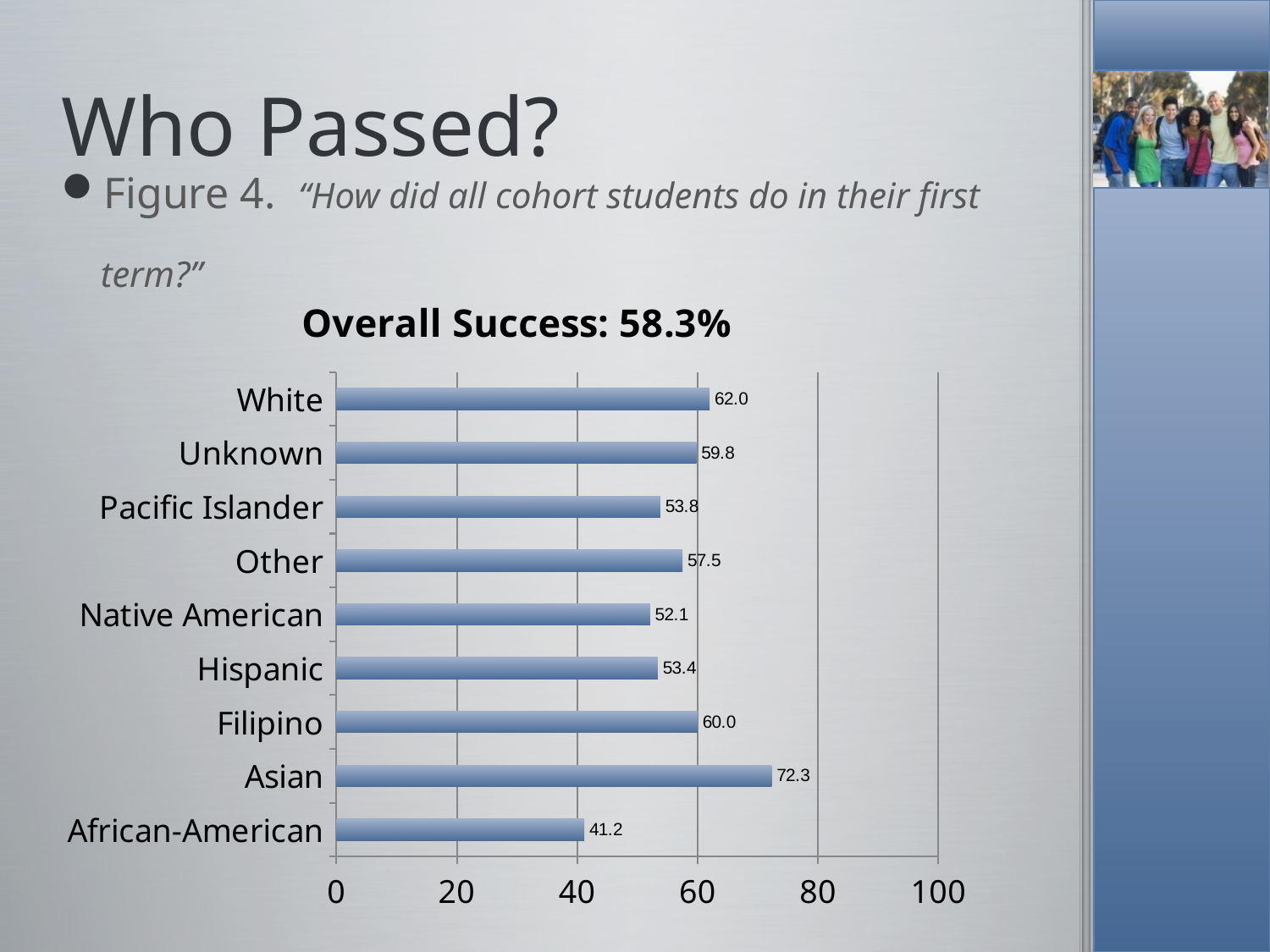
What is the title of the chart? Overall Success: 58.3% What is the difference between the values for White and Hispanic? 8.6 What is the value for Pacific Islander? 53.8 Which category has the lowest value? African-American What is the value for Asian? 72.3 Which category has the highest value? Asian Is the value for Unknown greater or less than 40? greater What kind of chart is shown on the slide? bar chart What is the value for Native American? 52.1 How many categories are shown in the chart? 9 Which is larger, the value for Filipino or the value for Other? Filipino What is the difference between the values for Asian and African-American? 31.1